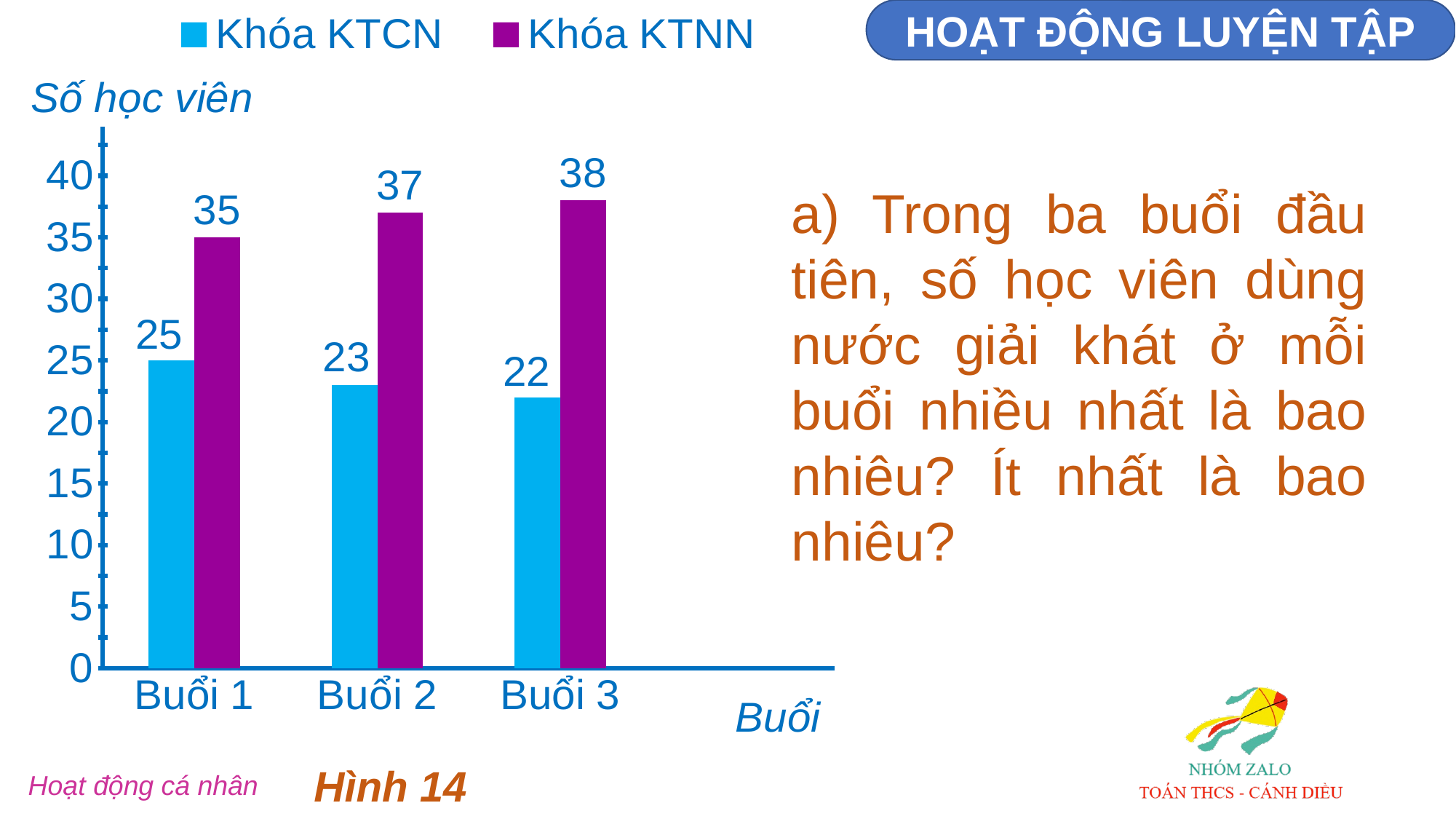
How many series does the legend list? 2 What is the value for Khóa KTCN in Buổi 1? 25 What is the difference between Khóa KTNN and Khóa KTCN in Buổi 1? 10 Which session (Buổi) has the lowest value for Khóa KTCN? Buổi 3 Which session (Buổi) has the highest value for Khóa KTNN? Buổi 3 What is the value for Khóa KTCN in Buổi 3? 22 What kind of chart is shown on the slide? bar chart How many sessions (Buổi) are shown on the x axis? 3 Which is larger in Buổi 2: Khóa KTCN or Khóa KTNN? Khóa KTNN What is the value for Khóa KTNN in Buổi 2? 37 Is the value for Khóa KTNN in Buổi 3 greater or less than 30? greater What is the label of the vertical axis? Số học viên